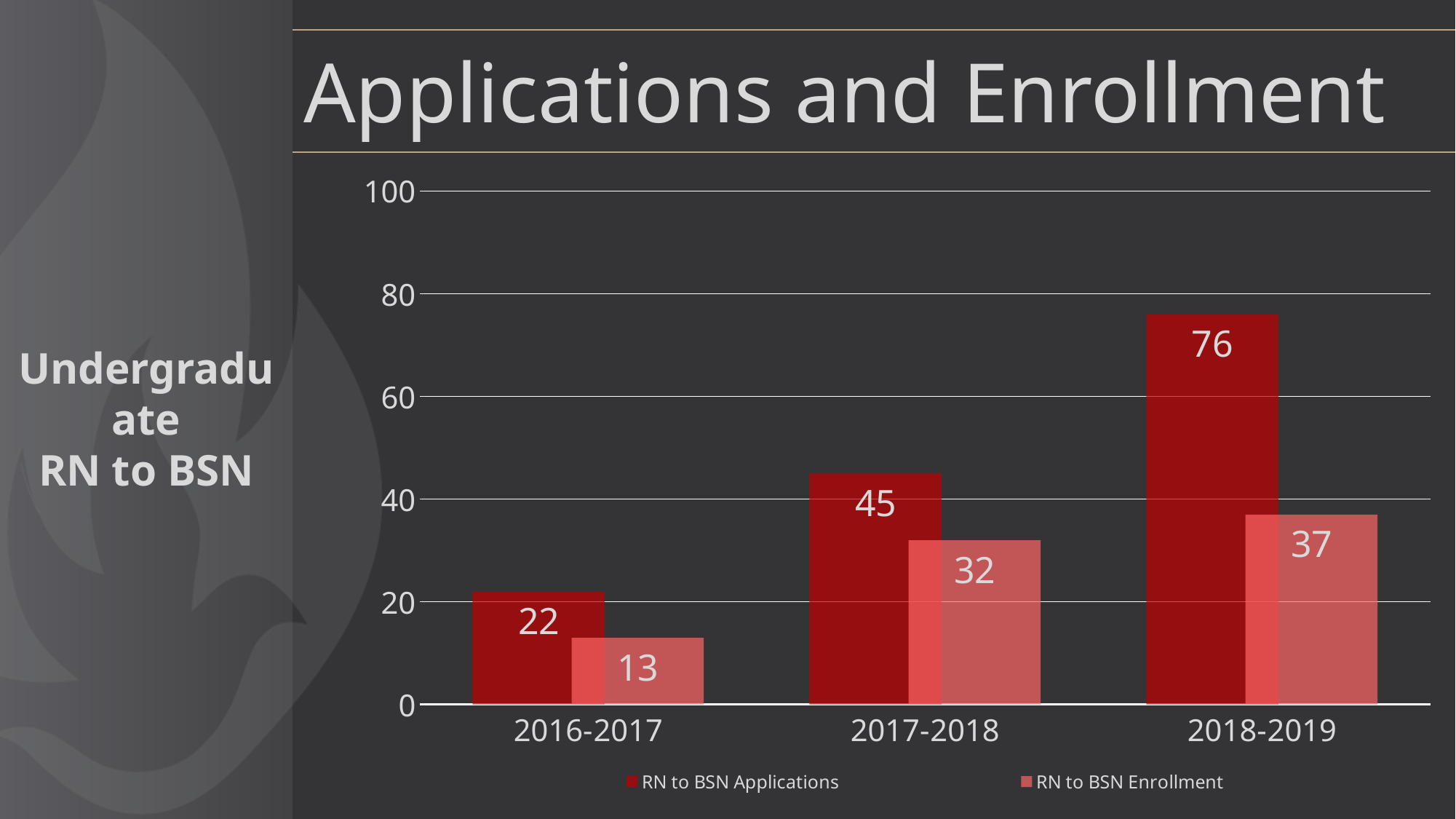
Which year has the lowest RN to BSN Enrollment value? 2016-2017 Which is larger: RN to BSN Enrollment in 2017-2018 or RN to BSN Applications in 2016-2017? RN to BSN Enrollment in 2017-2018 Do the RN to BSN Applications values rise or fall from 2016-2017 to 2018-2019? Rise What is the value of RN to BSN Applications for 2018-2019? 76 What is the difference between RN to BSN Applications and RN to BSN Enrollment in 2018-2019? 39 How many year categories are shown on the x axis? 3 What kind of chart is shown on the slide? Bar chart What is the value of RN to BSN Enrollment for 2017-2018? 32 Which year has the highest RN to BSN Applications value? 2018-2019 What is the value of RN to BSN Enrollment for 2016-2017? 13 What is the difference in RN to BSN Applications between 2017-2018 and 2016-2017? 23 How many series does the legend list? 2